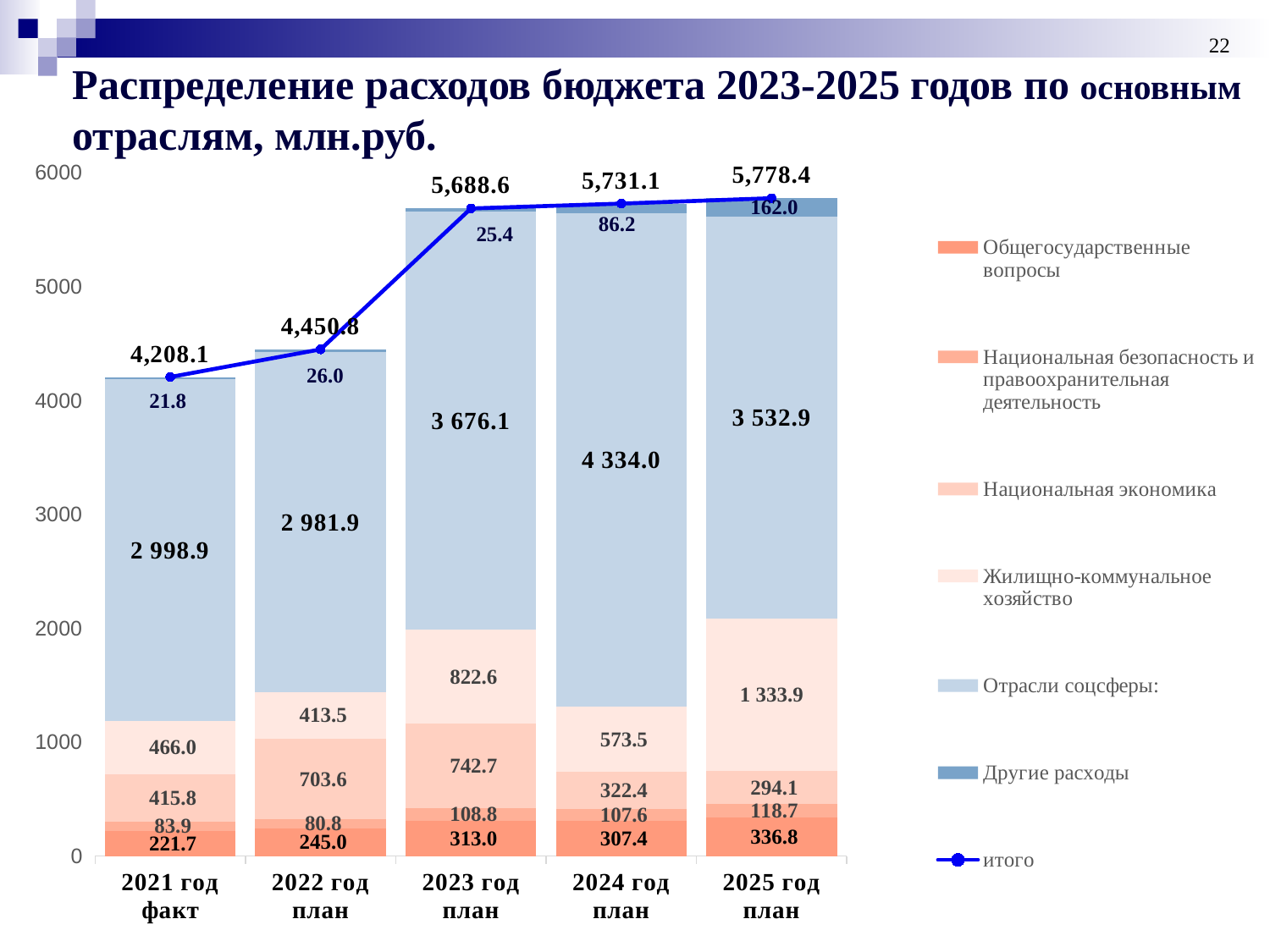
How many entries does the legend list? 7 What is the total (итого) value shown for 2023 год план? 5,688.6 Which year has the highest total (итого) value? 2025 год план Which year has the lowest total (итого) value? 2021 год факт What is the difference between the total for 2025 год план and the total for 2024 год план? 47.3 What is the value of Отрасли соцсферы for 2024 год план? 4 334.0 Which is larger: Национальная экономика for 2023 год план or for 2024 год план? 2023 год план What kind of chart is this? Stacked bar chart with a line Does the total (итого) line rise or fall from 2021 год факт to 2025 год план? Rises How many year categories are shown on the x axis? 5 What is the value of Жилищно-коммунальное хозяйство for 2025 год план? 1 333.9 What is the value of Общегосударственные вопросы for 2021 год факт? 221.7